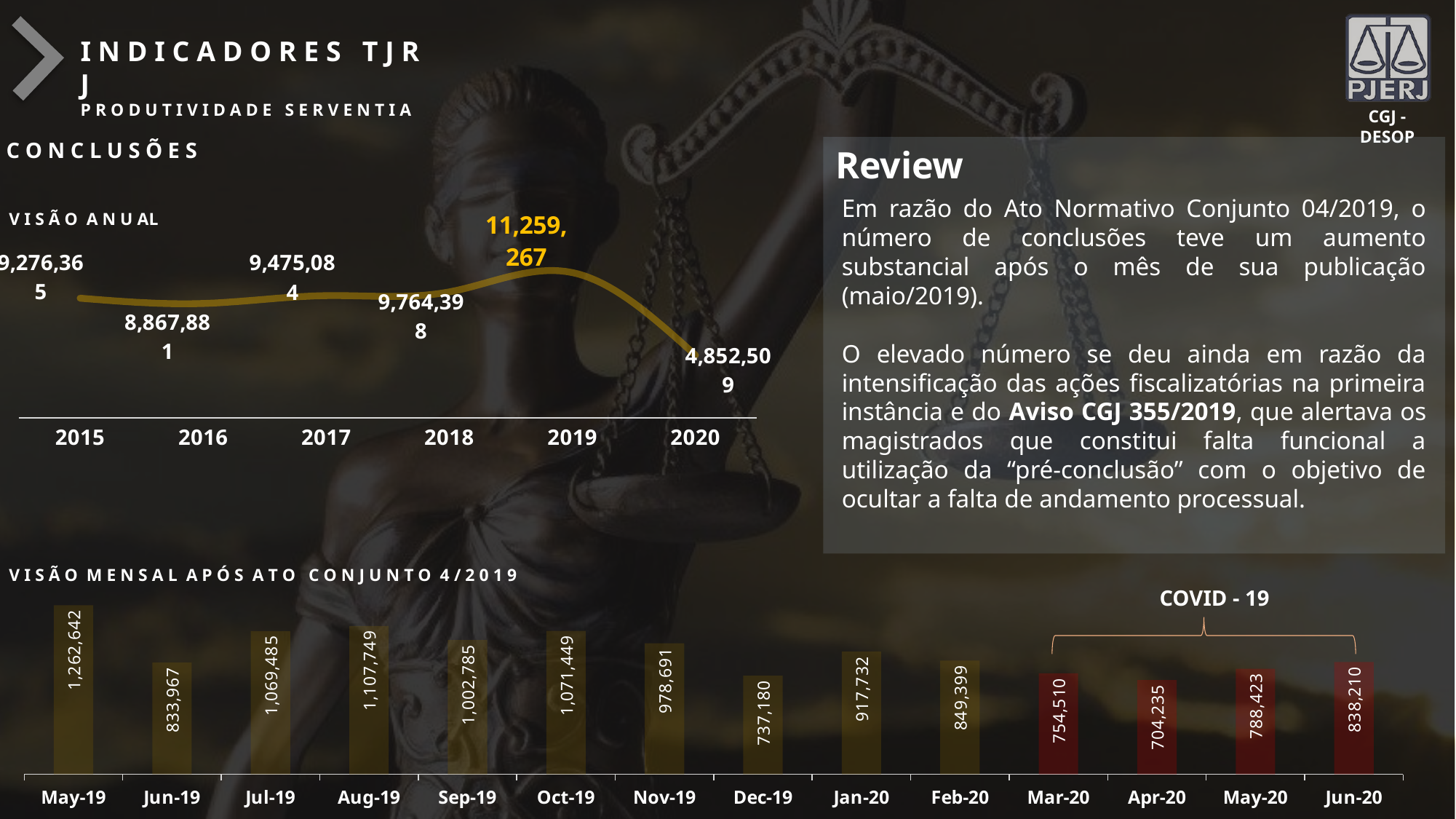
In the VISÃO ANUAL chart, what is the difference between the 2019 and 2020 values? 6,406,758 In the VISÃO MENSAL APÓS ATO CONJUNTO 4/2019 chart, what is the difference between May-19 and Apr-20? 558,407 In the VISÃO ANUAL chart, what is the value for 2019? 11,259,267 In the VISÃO MENSAL APÓS ATO CONJUNTO 4/2019 chart, which month has the lowest value? Apr-20 What kind of chart is the VISÃO ANUAL chart? Line chart In the VISÃO ANUAL chart, how many years are plotted? 6 In the VISÃO MENSAL APÓS ATO CONJUNTO 4/2019 chart, how many months are shown? 14 In the VISÃO ANUAL chart, which year has the lowest value? 2020 In the VISÃO MENSAL APÓS ATO CONJUNTO 4/2019 chart, which is larger, Aug-19 or Jul-19? Aug-19 In the VISÃO MENSAL APÓS ATO CONJUNTO 4/2019 chart, what is the value for Dec-19? 737,180 In the VISÃO MENSAL APÓS ATO CONJUNTO 4/2019 chart, which months are grouped under the COVID - 19 bracket? Mar-20, Apr-20, May-20, Jun-20 In the VISÃO MENSAL APÓS ATO CONJUNTO 4/2019 chart, which month has the highest value? May-19